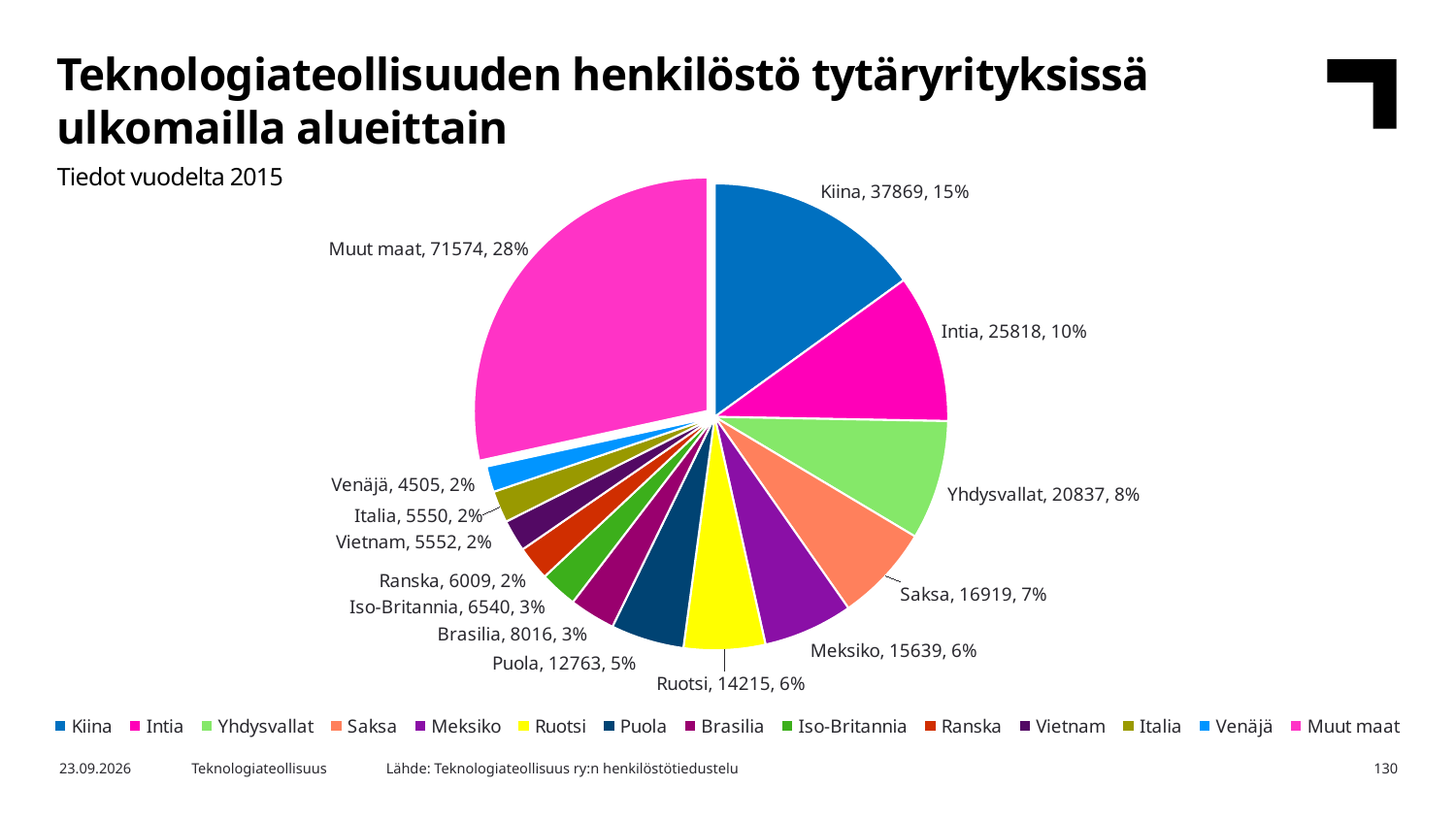
What share of the pie does Muut maat represent? 28% What is the value for Kiina? 37869 What type of chart is shown on the slide? pie chart Which is larger, the value for Meksiko or the value for Ruotsi? Meksiko What is the value for Saksa? 16919 Which category has the smallest slice? Venäjä What is the difference between the values for Kiina and Intia? 12051 What is the title of the chart? Teknologiateollisuuden henkilöstö tytäryrityksissä ulkomailla alueittain Which category has the largest slice? Muut maat What is the value for Puola? 12763 What share of the pie does Intia represent? 10% How many slices does the pie chart have? 14